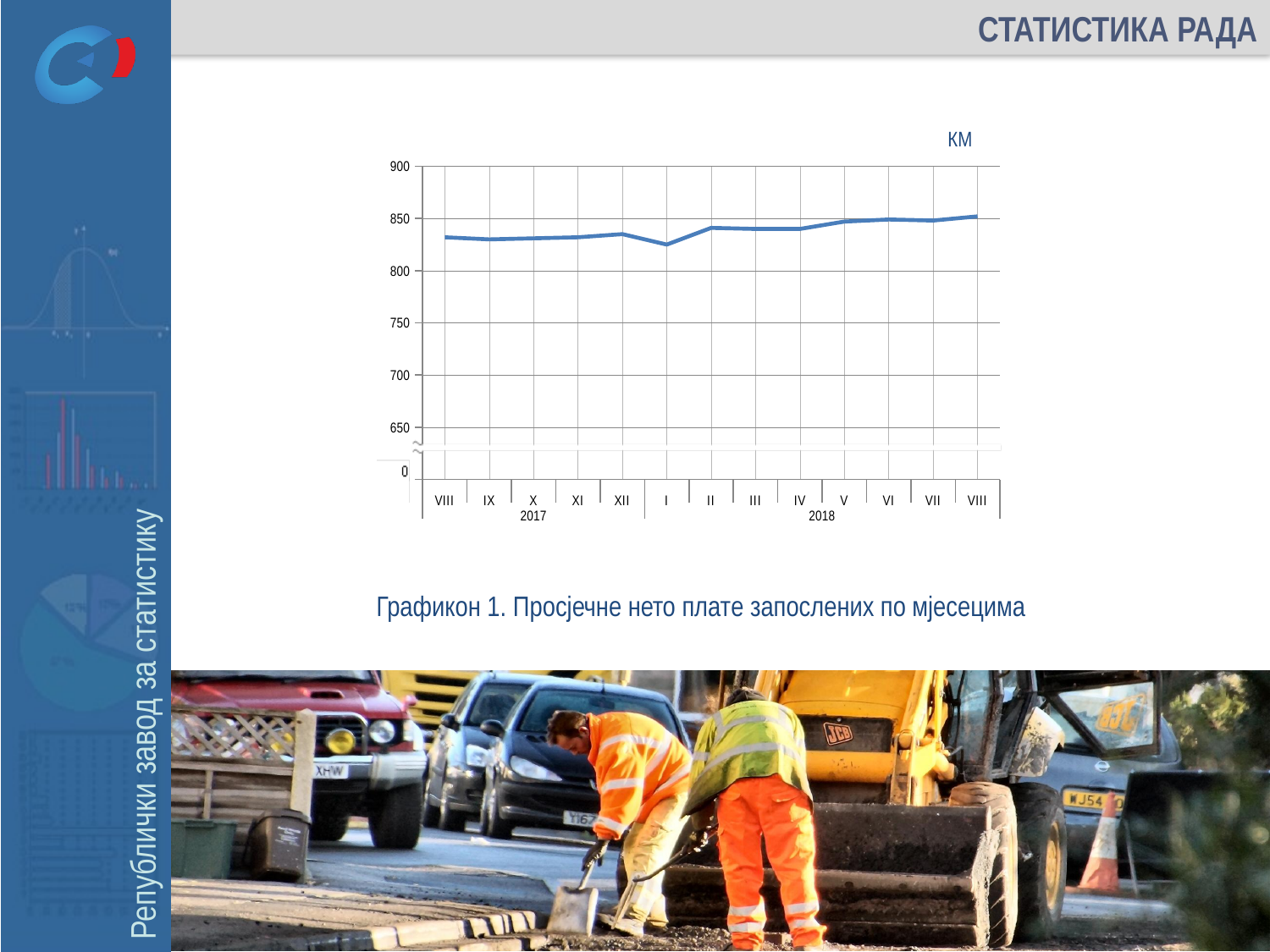
Is the value for I 2018 greater or less than 850? less Is the value for IV 2018 greater or less than 850? less Which is larger, the value for VIII 2017 or the value for VIII 2018? VIII 2018 What unit is shown above the chart's y axis? KM Is the value for VIII 2017 greater or less than 850? less Which month has the highest value on the chart? VIII 2018 Which is larger, the value for I 2018 or the value for II 2018? II 2018 Which month has the lowest value on the chart? I 2018 What kind of chart is shown on the slide? line chart Do the values generally rise or fall from VIII 2017 to VIII 2018? rise How many monthly data points are plotted on the chart? 13